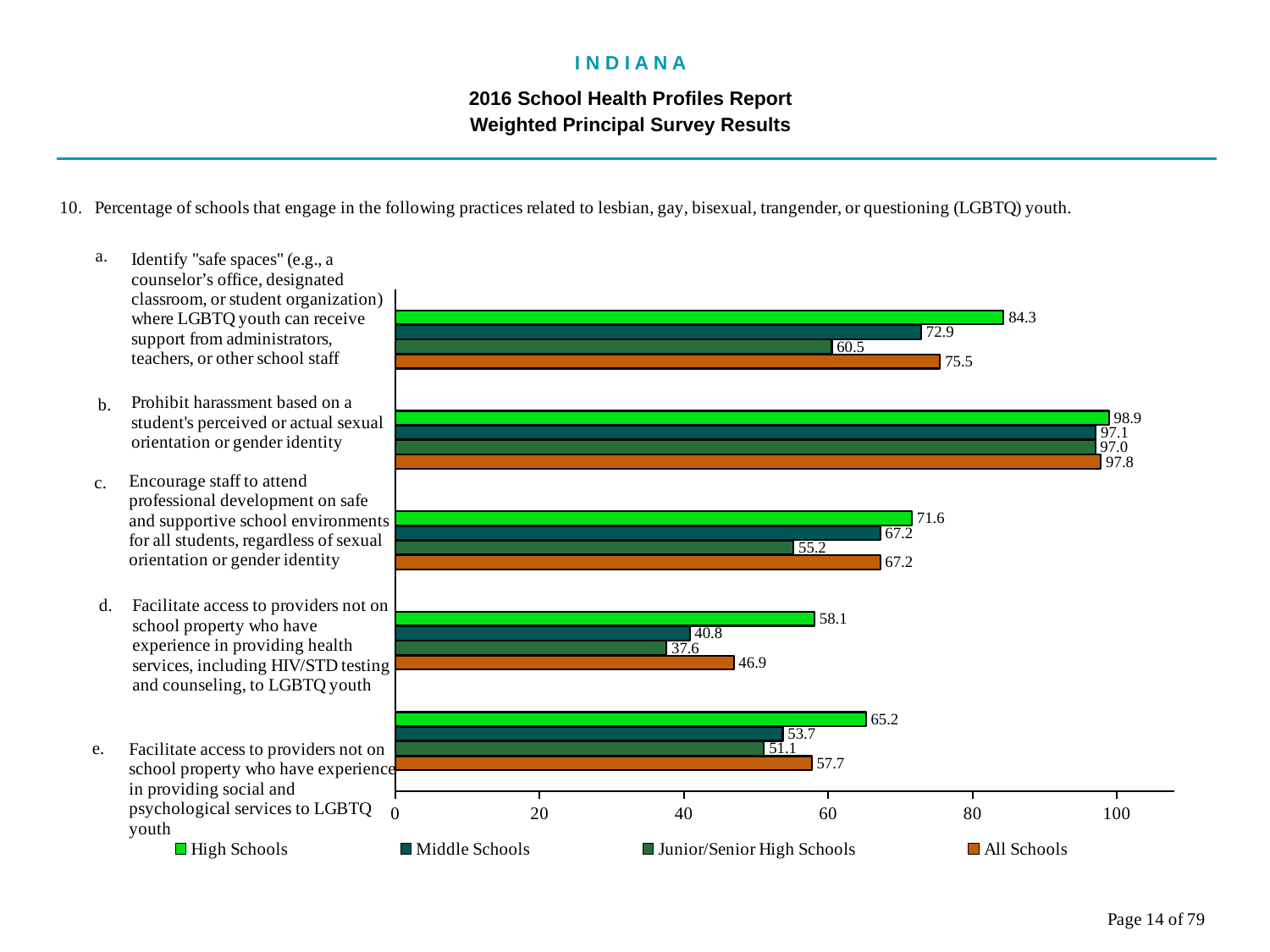
What kind of chart is shown on the slide? Bar chart What is the value for All Schools for practice d (facilitate access to providers with experience in health services, including HIV/STD testing)? 46.9 Which practice has the highest value for High Schools? b. Prohibit harassment based on a student's perceived or actual sexual orientation or gender identity How many series does the legend list? 4 What is the value for Junior/Senior High Schools for practice e (facilitate access to providers of social and psychological services)? 51.1 Which series is shown in orange in the legend? All Schools Which practice has the lowest value for Middle Schools? d. Facilitate access to providers not on school property who have experience in providing health services, including HIV/STD testing and counseling, to LGBTQ youth Is the All Schools value for practice e (facilitate access to providers of social and psychological services) greater or less than 60? less How many practices (categories) are shown in the chart? 5 What is the difference between the High Schools and Middle Schools values for practice a (identify "safe spaces")? 11.4 For practice c (encourage staff to attend professional development), which is larger: the Middle Schools value or the Junior/Senior High Schools value? Middle Schools What is the value for High Schools for practice a (identify "safe spaces")? 84.3